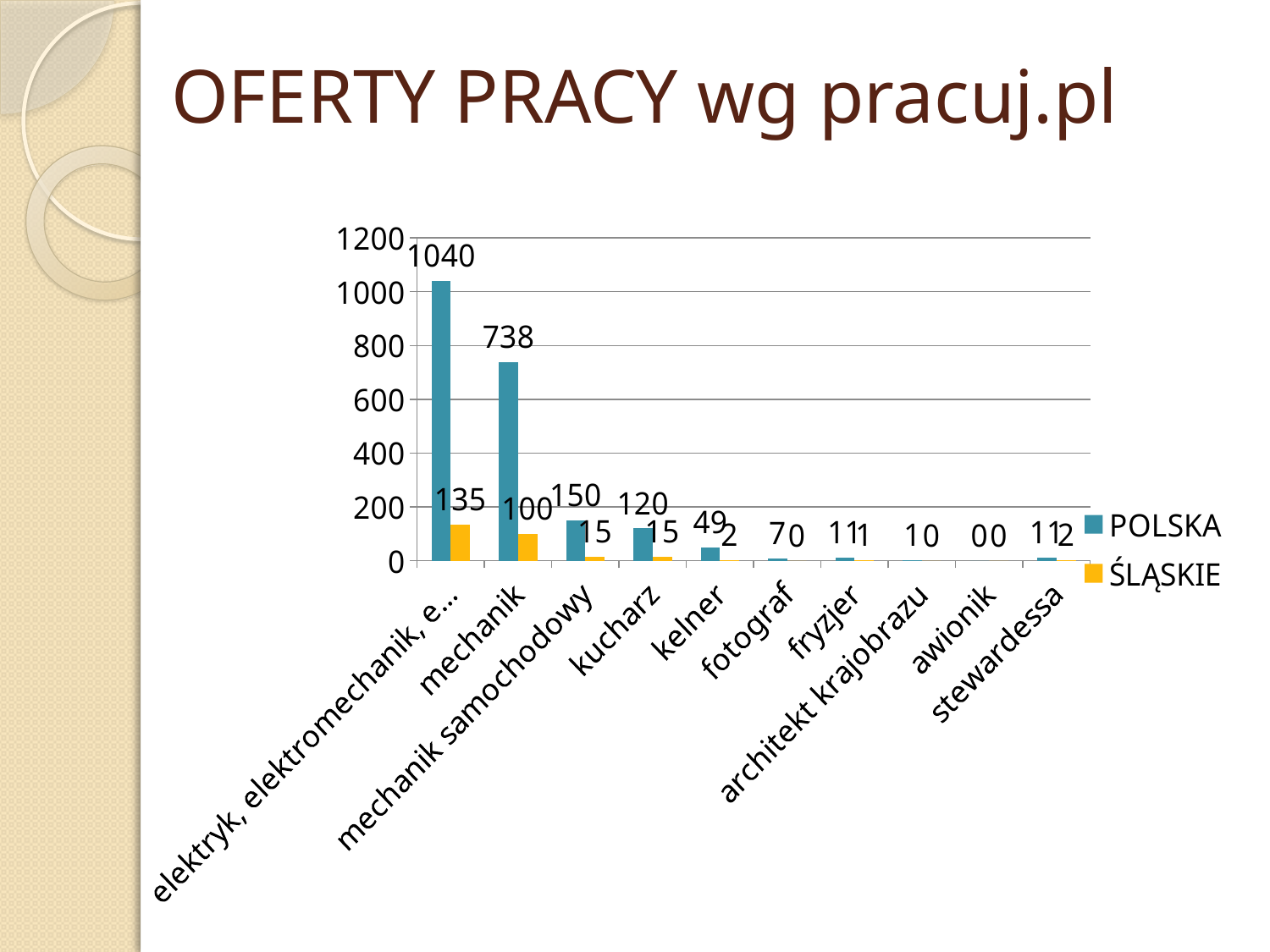
What is the POLSKA value for the category 'elektryk, elektromechanik, e...'? 1040 Is the POLSKA value for 'mechanik' greater or less than 600? greater What is the difference between the POLSKA values for 'elektryk, elektromechanik, e...' and 'mechanik'? 302 How many categories are shown on the x axis? 10 What is the ŚLĄSKIE value for 'mechanik'? 100 How many series does the legend list? 2 What is the POLSKA value for 'kelner'? 49 What is the title of the slide? OFERTY PRACY wg pracuj.pl What kind of chart is shown on the slide? bar chart Which has the larger POLSKA value, 'mechanik samochodowy' or 'kucharz'? mechanik samochodowy Which category has the highest POLSKA value? elektryk, elektromechanik, e... What is the difference between the POLSKA and ŚLĄSKIE values for 'kucharz'? 105